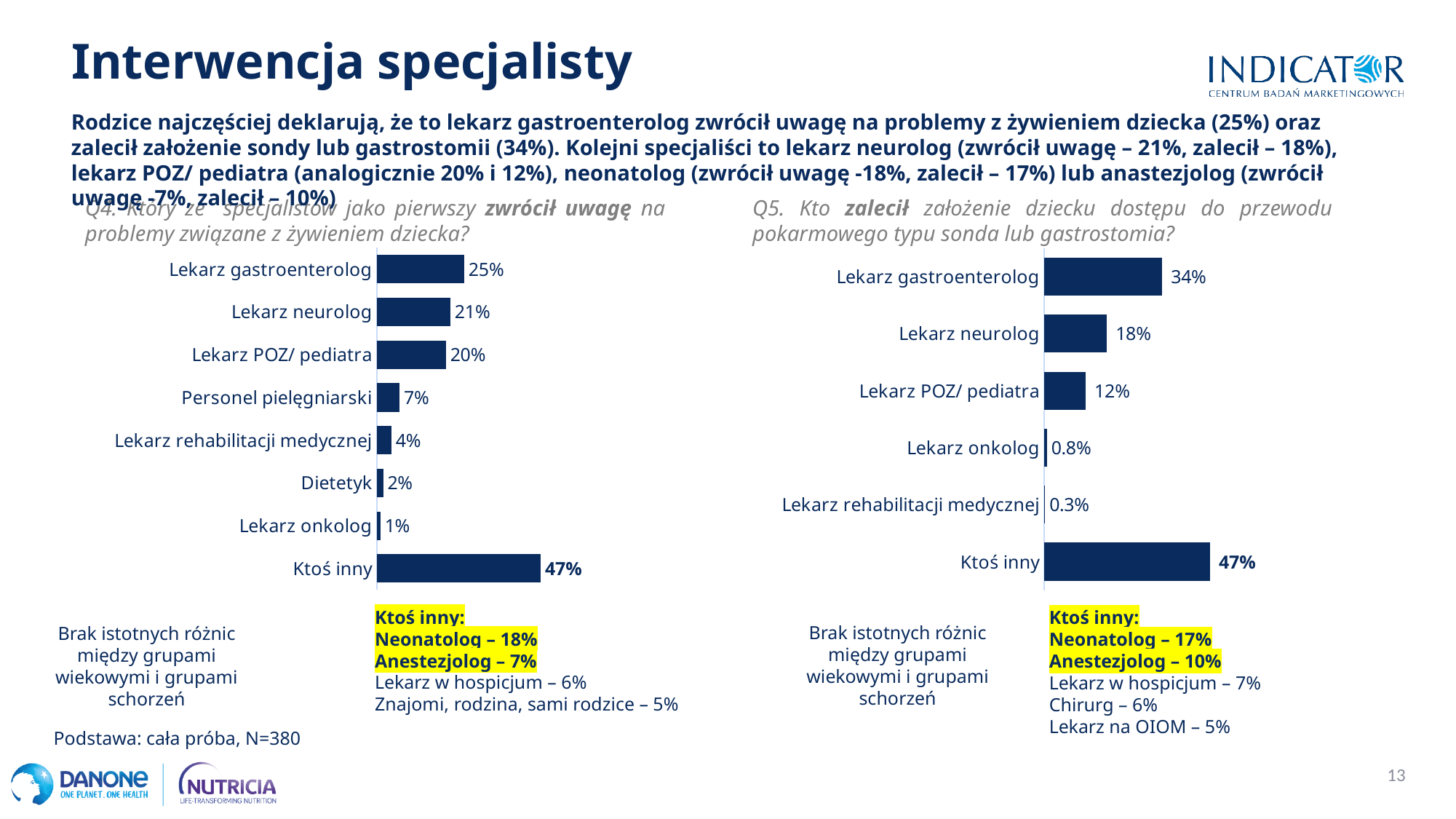
In the right chart (Q5), what is the value for Lekarz POZ/ pediatra? 12% In the left chart (Q4), which is larger: Personel pielęgniarski or Dietetyk? Personel pielęgniarski In the left chart (Q4), what is the value for Lekarz rehabilitacji medycznej? 4% In the left chart (Q4), what is the difference between Lekarz gastroenterolog and Lekarz neurolog? 4% How many categories are shown in the right chart (Q5)? 6 What type of chart is used on the left (Q4)? Bar chart In the right chart (Q5), which category has the lowest value? Lekarz rehabilitacji medycznej In the right chart (Q5), what is the value for Lekarz onkolog? 0.8% In the left chart (Q4), what is the value for Lekarz gastroenterolog? 25% In the left chart (Q4), which category has the highest value? Ktoś inny How many categories are shown in the left chart (Q4)? 8 In the right chart (Q5), what is the difference between Lekarz gastroenterolog and Lekarz neurolog? 16%